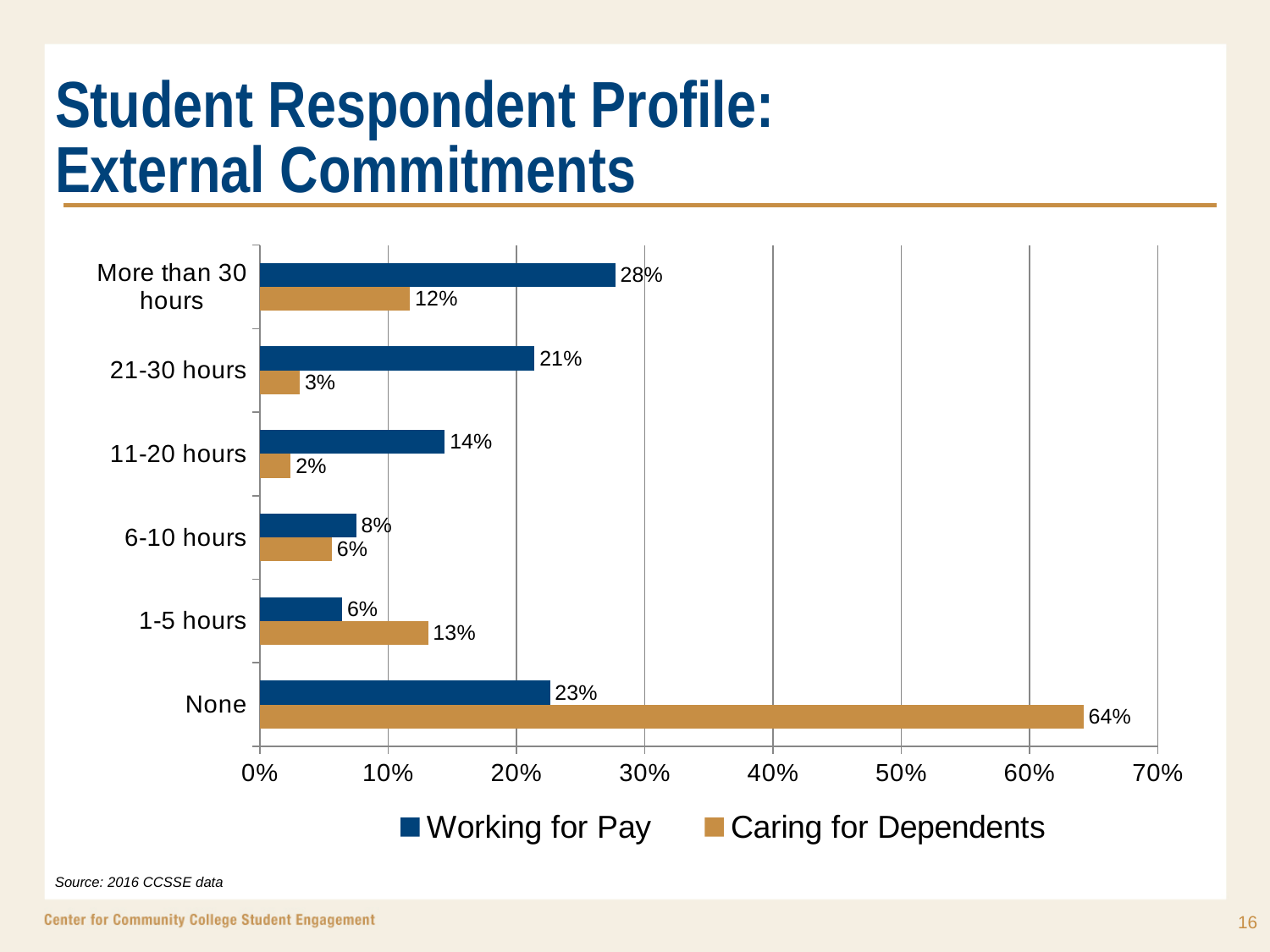
Is the value for Caring for Dependents in the None category greater or less than 60%? greater What is the source of the data cited on the slide? 2016 CCSSE data What kind of chart is shown on the slide? Bar chart What is the value for Caring for Dependents in the None category? 64% What is the difference between Working for Pay and Caring for Dependents for 21-30 hours? 18% Which category has the highest value for Working for Pay? More than 30 hours What percentage of respondents care for dependents for 1-5 hours? 13% How many hour categories are shown on the chart? 6 How many series does the legend list? 2 What percentage of respondents work for pay more than 30 hours? 28% Which is larger for 1-5 hours: Working for Pay or Caring for Dependents? Caring for Dependents Which category has the lowest value for Caring for Dependents? 11-20 hours